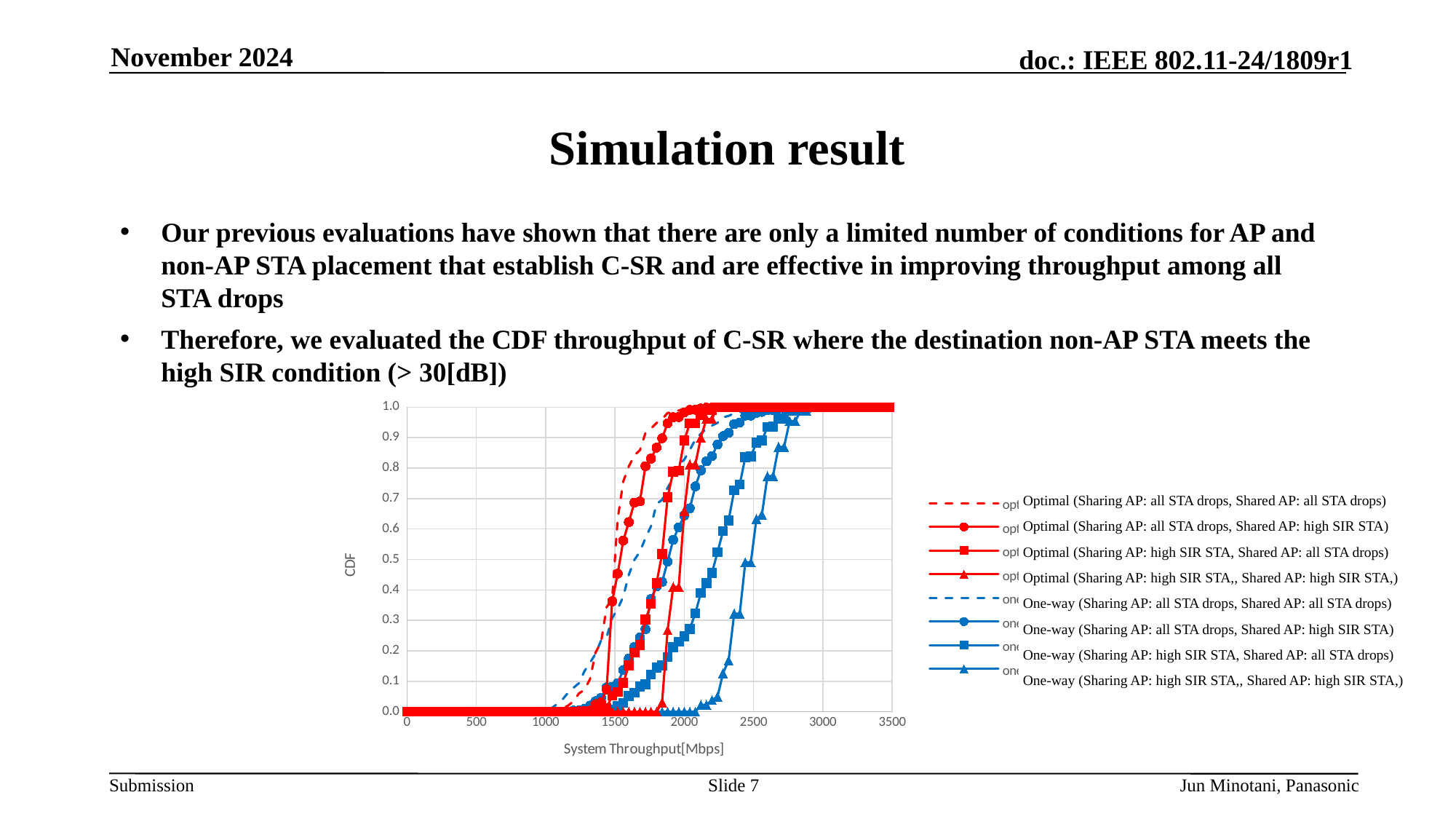
What is the label of the x axis of the chart? System Throughput[Mbps] Which series reaches a CDF of 1.0 at the highest System Throughput (the rightmost curve)? One-way (Sharing AP: high SIR STA,, Shared AP: high SIR STA,) Is the CDF value of the 'One-way (Sharing AP: high SIR STA,, Shared AP: high SIR STA,)' series at 2000 Mbps greater or less than 0.1? less At 2500 Mbps, which series has the higher CDF value: 'Optimal (Sharing AP: all STA drops, Shared AP: all STA drops)' or 'One-way (Sharing AP: high SIR STA,, Shared AP: high SIR STA,)'? Optimal (Sharing AP: all STA drops, Shared AP: all STA drops) What is the maximum value shown on the x axis of the chart? 3500 What is the label of the y axis of the chart? CDF What kind of chart is shown on the slide? line chart Is the CDF value of the 'One-way (Sharing AP: high SIR STA, Shared AP: all STA drops)' series at 2000 Mbps greater or less than 0.5? less Is the CDF value of the 'Optimal (Sharing AP: all STA drops, Shared AP: all STA drops)' series at 2000 Mbps greater or less than 0.9? greater How many series does the legend of the chart list? 8 Do the CDF curves rise or fall as System Throughput increases along the x axis? rise